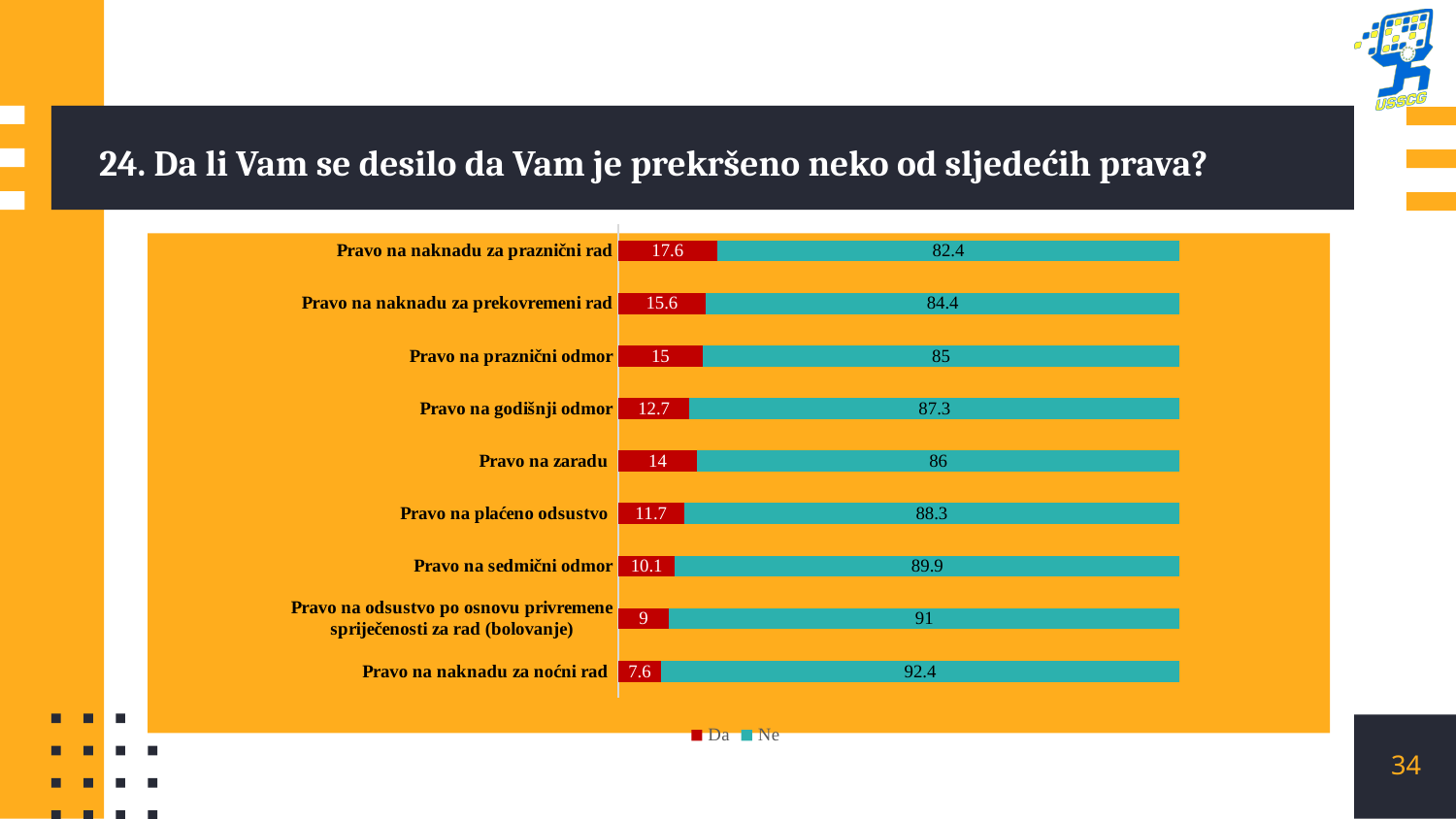
What is the 'Ne' value for 'Pravo na godišnji odmor'? 87.3 What is the 'Da' value for 'Pravo na naknadu za noćni rad'? 7.6 Which category has the highest 'Da' value? Pravo na naknadu za praznični rad How many categories are shown in the chart? 9 What kind of chart is shown on the slide? Stacked bar chart Which is larger: the 'Da' value for 'Pravo na zaradu' or for 'Pravo na plaćeno odsustvo'? Pravo na zaradu Which category has the lowest 'Da' value? Pravo na naknadu za noćni rad What are the two legend entries of the chart? Da and Ne How many series does the legend list? 2 What is the 'Da' value for 'Pravo na naknadu za praznični rad'? 17.6 What is the total of the stacked bar for 'Pravo na sedmični odmor'? 100 What is the difference between the 'Ne' values for 'Pravo na naknadu za noćni rad' and 'Pravo na naknadu za praznični rad'? 10